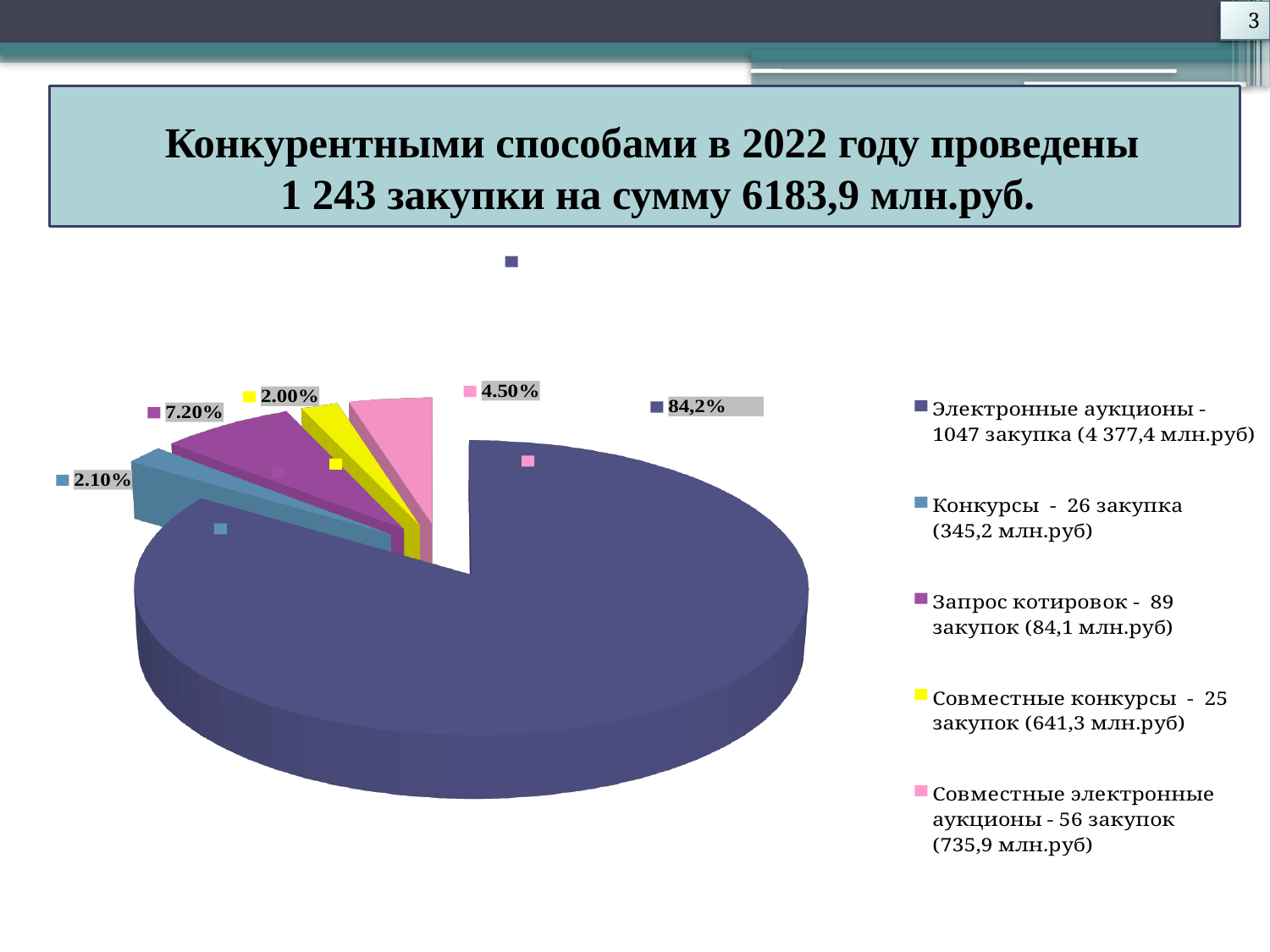
Which category has the largest slice of the pie? Электронные аукционы Which category has the smallest slice of the pie? Совместные конкурсы What is the difference in percentage points between Запрос котировок and Совместные электронные аукционы? 2.70% How many entries does the legend list? 5 What percentage is shown for Совместные электронные аукционы? 4.50% Which is larger, the share for Запрос котировок or the share for Совместные электронные аукционы? Запрос котировок What percentage is shown for Совместные конкурсы? 2.00% What share of the pie is labelled for Электронные аукционы? 84,2% What kind of chart is shown on the slide? pie chart What percentage is shown for Конкурсы? 2.10% What percentage is shown for Запрос котировок? 7.20% How many slices does the pie chart have? 5